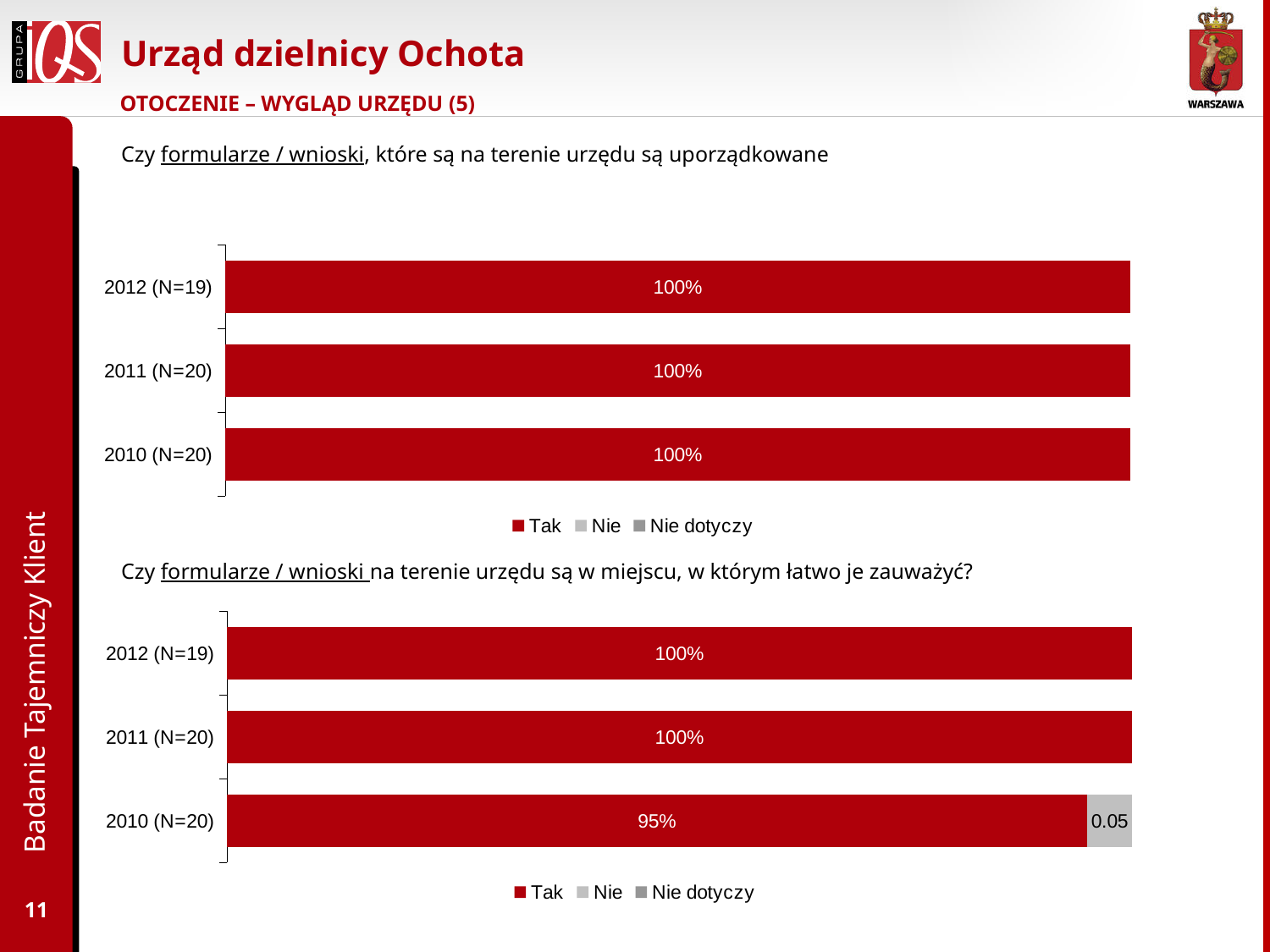
In the bottom chart, what is the 'Tak' value for 2010 (N=20)? 95% In the bottom chart, is the 'Tak' value for 2012 (N=19) larger or smaller than for 2010 (N=20)? larger What type of chart is the top chart? bar chart In the top chart, what is the 'Tak' value for 2012 (N=19)? 100% What are the legend entries of the top chart? Tak, Nie, Nie dotyczy In the bottom chart, does the 'Tak' value rise or fall from 2010 to 2012? rise How many categories (years) does the top chart show? 3 In the bottom chart, what is the 'Nie' value shown for 2010 (N=20)? 0.05 In the bottom chart, what is the difference between the 'Tak' values for 2011 (N=20) and 2010 (N=20)? 5% How many series does the legend of the bottom chart list? 3 In the bottom chart, which year has the lowest 'Tak' value? 2010 (N=20) In the bottom chart, what is the 'Tak' value for 2011 (N=20)? 100%